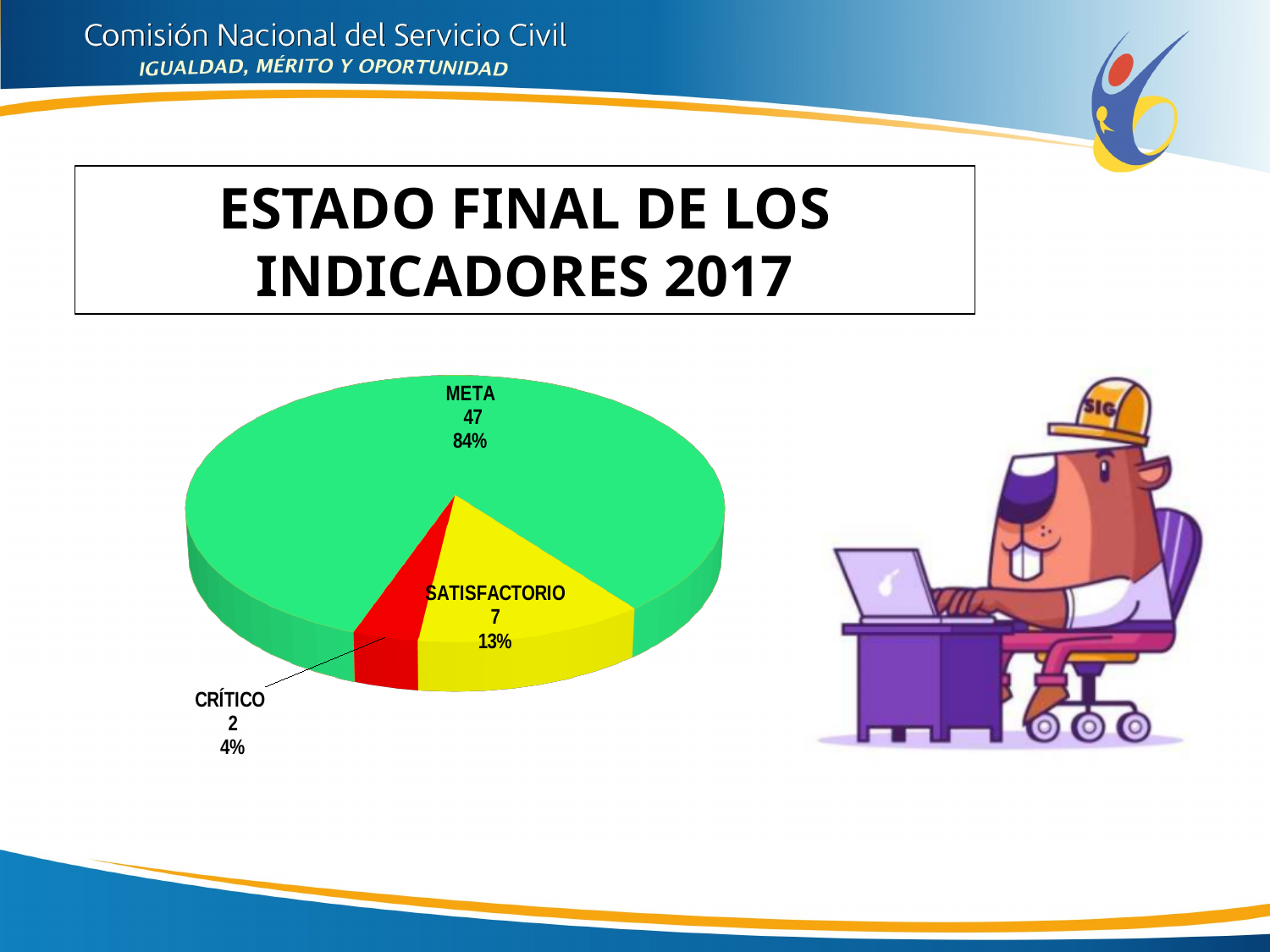
Which category has the largest slice? META Which category has the smallest slice? CRÍTICO How many slices does the pie chart have? 3 What is the value for META? 47 What is the difference between the values for META and SATISFACTORIO? 40 What share of the pie does META represent? 84% What share of the pie does CRÍTICO represent? 4% What is the value for CRÍTICO? 2 What kind of chart is shown on the slide? pie chart What colour is the CRÍTICO slice? red What share of the pie does SATISFACTORIO represent? 13% What is the value for SATISFACTORIO? 7